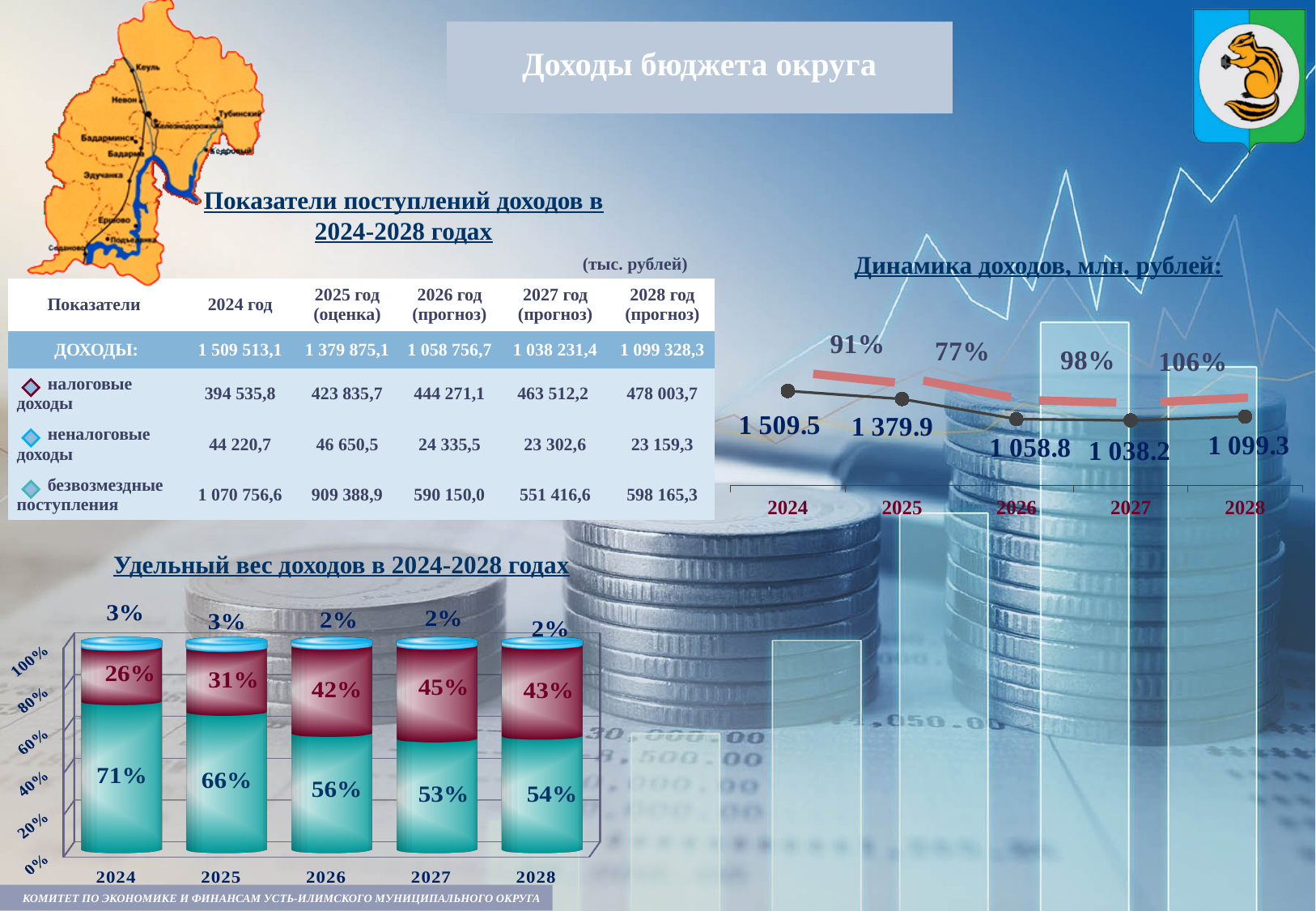
What kind of chart is 'Удельный вес доходов в 2024-2028 годах'? stacked bar chart On the chart 'Динамика доходов, млн. рублей', what is the difference between the 2024 and 2025 values? 129.6 On the chart 'Динамика доходов, млн. рублей', which year has the highest value? 2024 On the chart 'Динамика доходов, млн. рублей', which year has the lowest value? 2027 On the chart 'Динамика доходов, млн. рублей', how many years are plotted? 5 On the chart 'Удельный вес доходов в 2024-2028 годах', what is the value of the bottom (teal) segment for 2024? 71% On the chart 'Динамика доходов, млн. рублей', what is the value for 2024? 1 509.5 On the chart 'Удельный вес доходов в 2024-2028 годах', does the bottom (teal) segment generally rise or fall from 2024 to 2027? fall On the chart 'Удельный вес доходов в 2024-2028 годах', what is the value of the middle (red) segment for 2027? 45% On the chart 'Динамика доходов, млн. рублей', what is the value for 2027? 1 038.2 On the chart 'Динамика доходов, млн. рублей', what percentage is shown between 2026 and 2027? 98% On the chart 'Удельный вес доходов в 2024-2028 годах', what is the value of the top segment for 2028? 2%